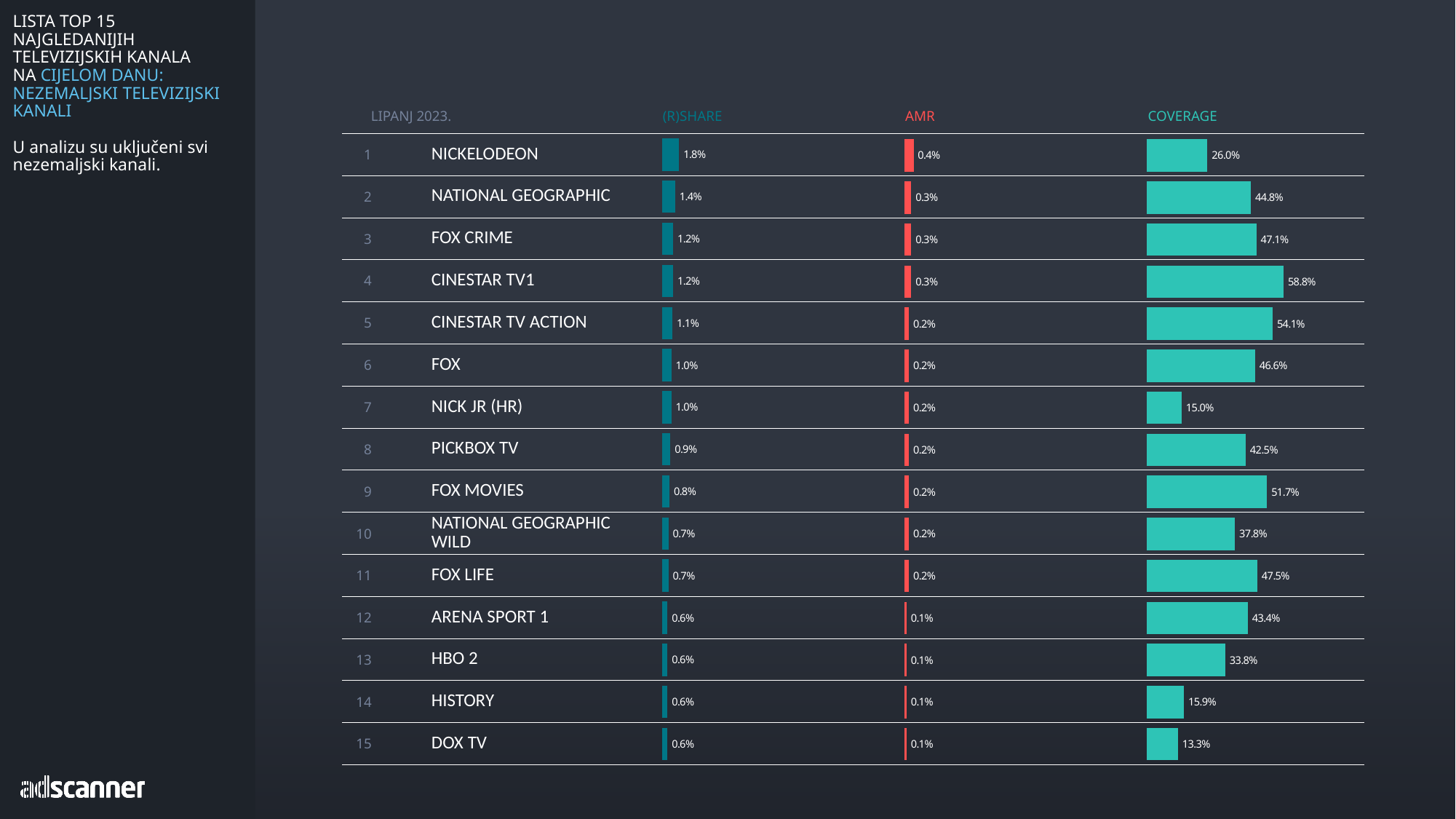
What is the difference in (R)SHARE between NICKELODEON and NATIONAL GEOGRAPHIC? 0.4 percentage points What is the difference in COVERAGE between CINESTAR TV1 and DOX TV? 45.5 percentage points Which has the larger COVERAGE value, PICKBOX TV or HBO 2? PICKBOX TV What is the (R)SHARE value for FOX CRIME? 1.2% Which channel has the highest COVERAGE value? CINESTAR TV1 What is the COVERAGE value for NICKELODEON? 26.0% Which channel has the highest (R)SHARE value? NICKELODEON Do the (R)SHARE values rise or fall going down the list from rank 1 to rank 15? Fall Which channel has the lowest COVERAGE value? DOX TV What kind of chart is used to show the COVERAGE values? Bar chart What is the AMR value for NICKELODEON? 0.4% How many channels are listed in the table? 15